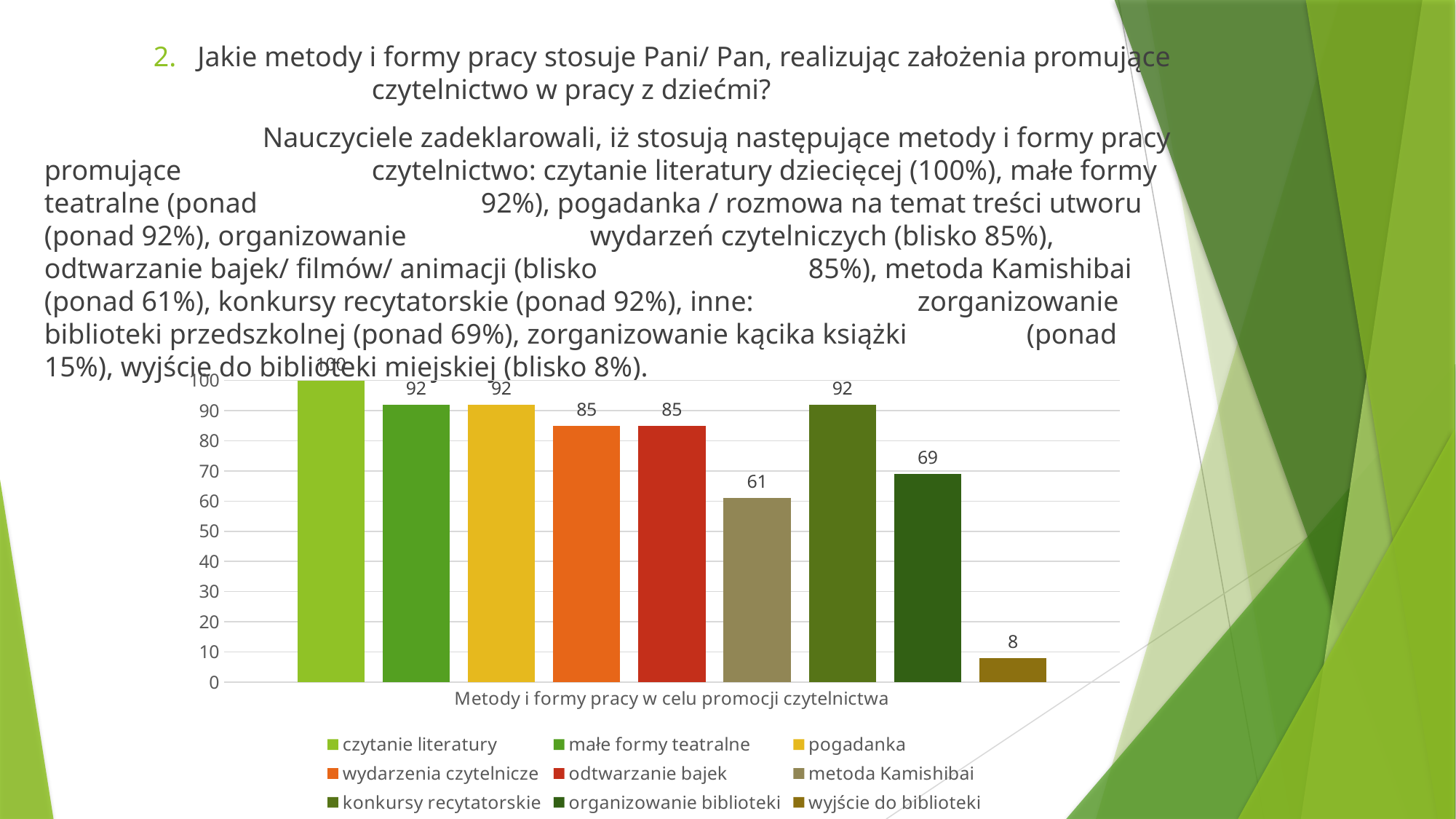
What is the value for 'wydarzenia czytelnicze'? 85 What is the value for 'wyjście do biblioteki'? 8 What is the difference between the values for 'organizowanie biblioteki' and 'wyjście do biblioteki'? 61 Which series has the highest value? czytanie literatury Which series has the lowest value? wyjście do biblioteki What kind of chart is shown on the slide? bar chart What is the value for 'metoda Kamishibai'? 61 What is the difference between the values for 'małe formy teatralne' and 'metoda Kamishibai'? 31 What is the category label shown on the x axis of the chart? Metody i formy pracy w celu promocji czytelnictwa How many series does the legend list? 9 Which is larger, the value for 'organizowanie biblioteki' or the value for 'odtwarzanie bajek'? odtwarzanie bajek What is the value for 'organizowanie biblioteki'? 69